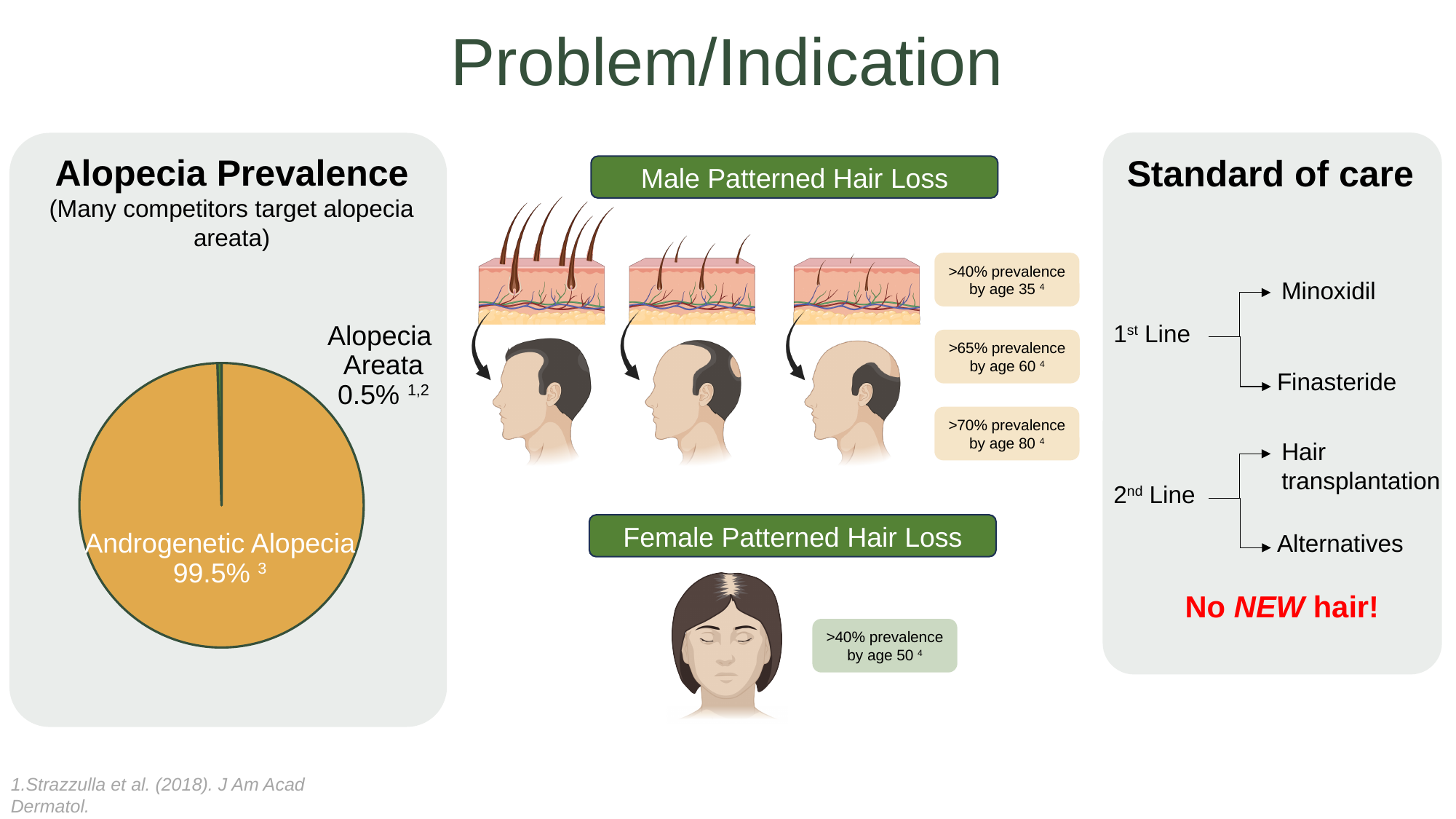
In the Alopecia Prevalence pie chart, which is larger: Androgenetic Alopecia or Alopecia Areata? Androgenetic Alopecia What is the heading above the pie chart on the left of the slide? Alopecia Prevalence In the Alopecia Prevalence pie chart, is the share for Androgenetic Alopecia greater or less than 50%? greater In the Alopecia Prevalence pie chart, what share is labelled for Androgenetic Alopecia? 99.5% Which slice of the Alopecia Prevalence pie chart is the largest? Androgenetic Alopecia What kind of chart is shown under the heading "Alopecia Prevalence"? Pie chart Which slice of the Alopecia Prevalence pie chart is the smallest? Alopecia Areata In the Alopecia Prevalence pie chart, what is the difference in percentage points between Androgenetic Alopecia and Alopecia Areata? 99 percentage points How many slices does the Alopecia Prevalence pie chart have? 2 In the Alopecia Prevalence pie chart, what share is labelled for Alopecia Areata? 0.5% What colour is the Androgenetic Alopecia slice in the Alopecia Prevalence pie chart? Orange/gold